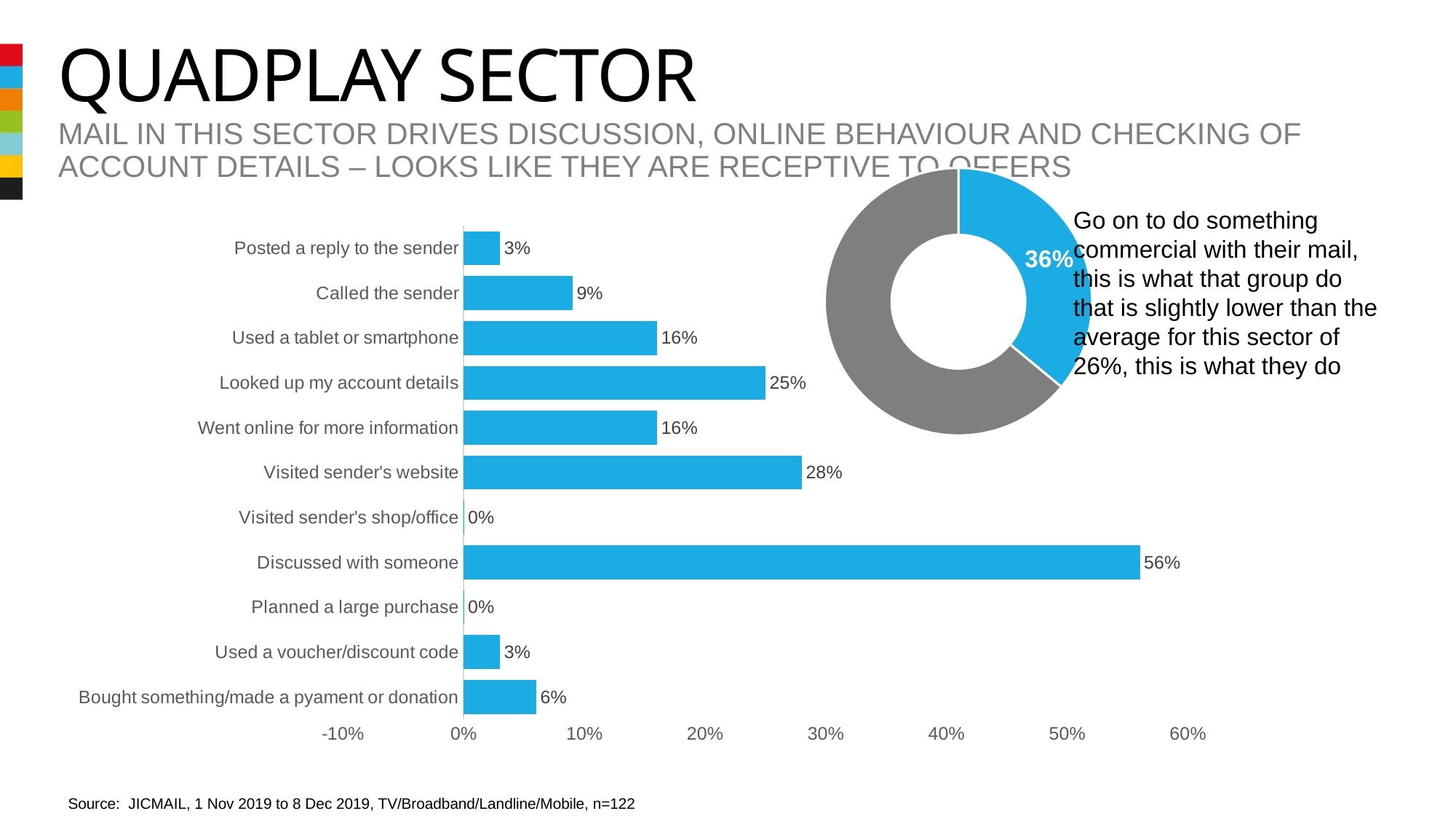
In the bar chart on the left, which is larger: 'Used a tablet or smartphone' or 'Bought something/made a pyament or donation'? Used a tablet or smartphone In the bar chart on the left, how many categories have a value of 0%? 2 In the bar chart on the left, what is the value for 'Called the sender'? 9% What kind of chart is the chart on the left of the slide? bar chart In the donut chart on the right, what value is shown for the blue slice? 36% In the bar chart on the left, what is the value for 'Looked up my account details'? 25% In the bar chart on the left, which category has the highest value? Discussed with someone In the bar chart on the left, is the value for 'Discussed with someone' greater or less than 50%? greater What kind of chart is the chart on the right of the slide? donut chart How many categories are shown in the bar chart on the left? 11 In the bar chart on the left, what is the difference between 'Visited sender's website' and 'Looked up my account details'? 3% In the bar chart on the left, what is the value for 'Discussed with someone'? 56%